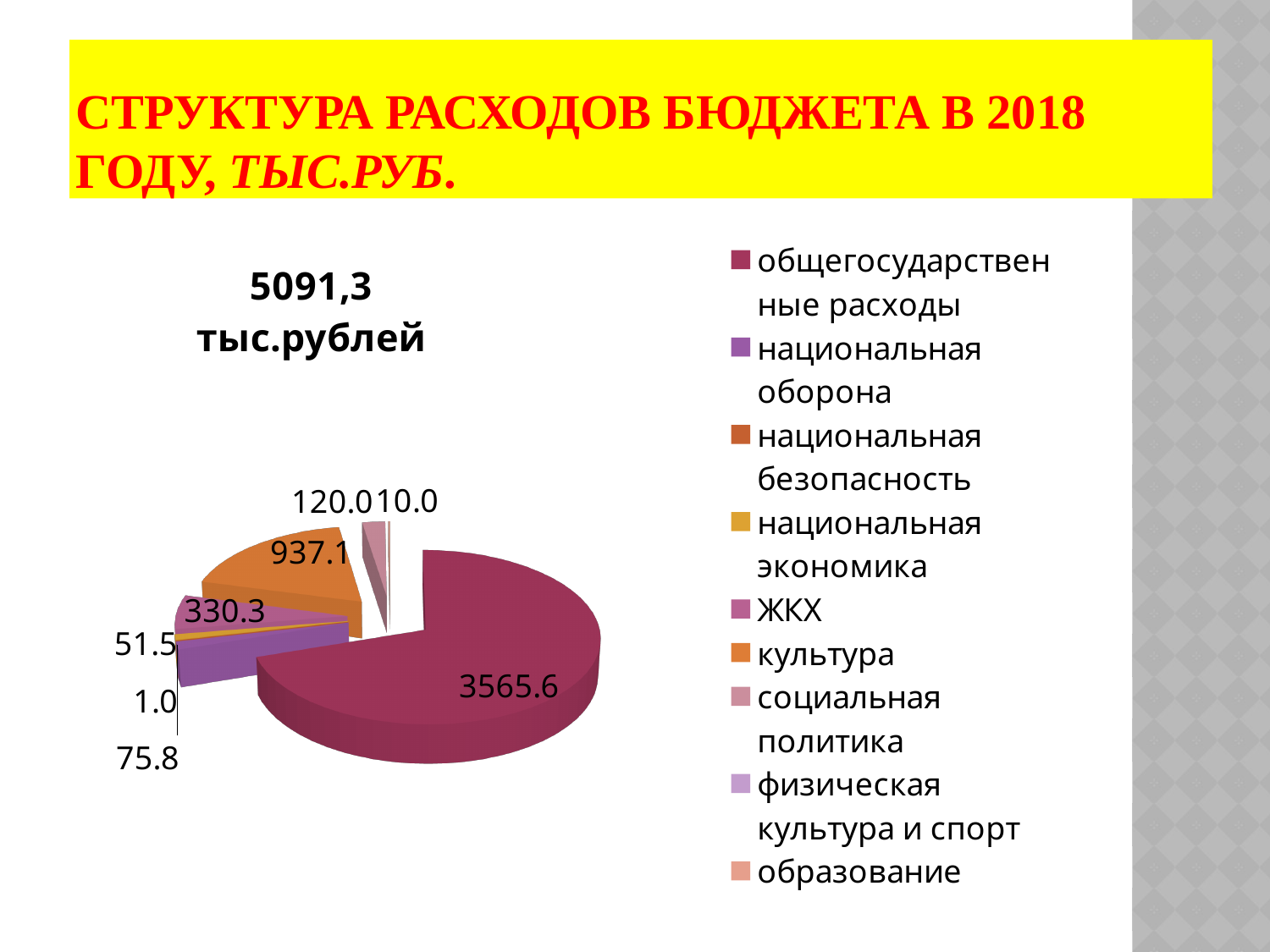
What is the value shown for национальная оборона? 75.8 What is the value shown for социальная политика? 120.0 What is the largest data label printed on the pie chart? 3565.6 What is the difference between the values for культура and национальная оборона? 861.3 Which category has the largest slice of the pie chart? общегосударственные расходы How many categories does the legend of the pie chart list? 9 What is the title shown above the pie chart? 5091,3 тыс.рублей What is the value shown for культура? 937.1 What is the value shown for общегосударственные расходы? 3565.6 Which is larger, the value for культура or the value for национальная оборона? культура What kind of chart is shown on the slide? pie chart What is the difference between the values for общегосударственные расходы and культура? 2628.5